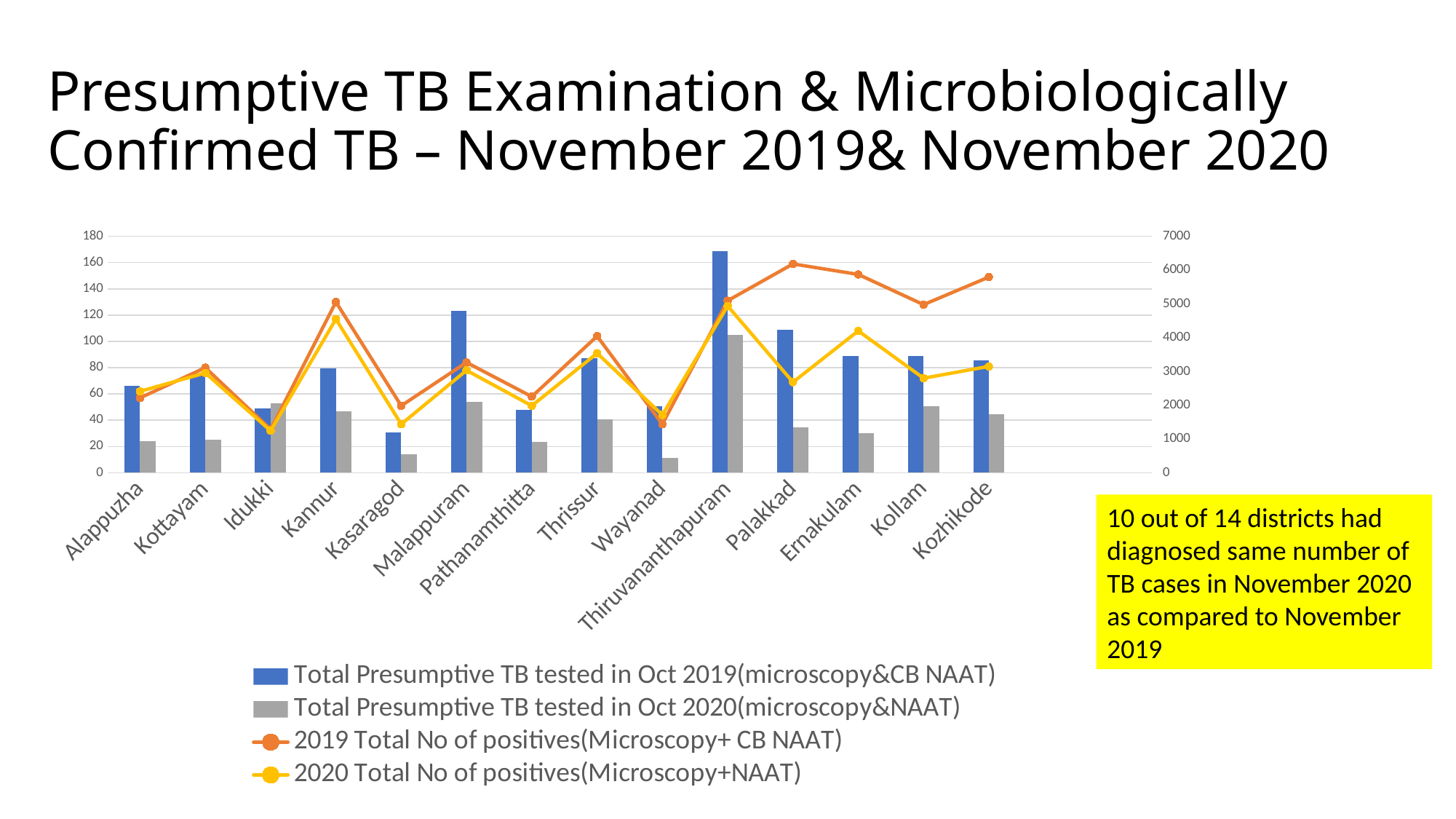
Which district has the lowest point on the orange line (2019 Total No of positives)? Idukki Which district has the taller blue bar, Kannur or Malappuram? Malappuram How many districts are shown along the x axis of the chart? 14 Which district has the shortest blue bar (Total Presumptive TB tested in Oct 2019)? Kasaragod What kind of chart is shown on the slide? A combination bar and line chart Which district has the highest point on the orange line (2019 Total No of positives)? Palakkad Which district has the tallest blue bar (Total Presumptive TB tested in Oct 2019)? Thiruvananthapuram How many series does the chart legend list? 4 Which district has the lowest point on the yellow line (2020 Total No of positives)? Idukki Which colour is used for the 2020 Total No of positives (Microscopy+NAAT) line? Yellow Which district has the highest point on the yellow line (2020 Total No of positives)? Thiruvananthapuram